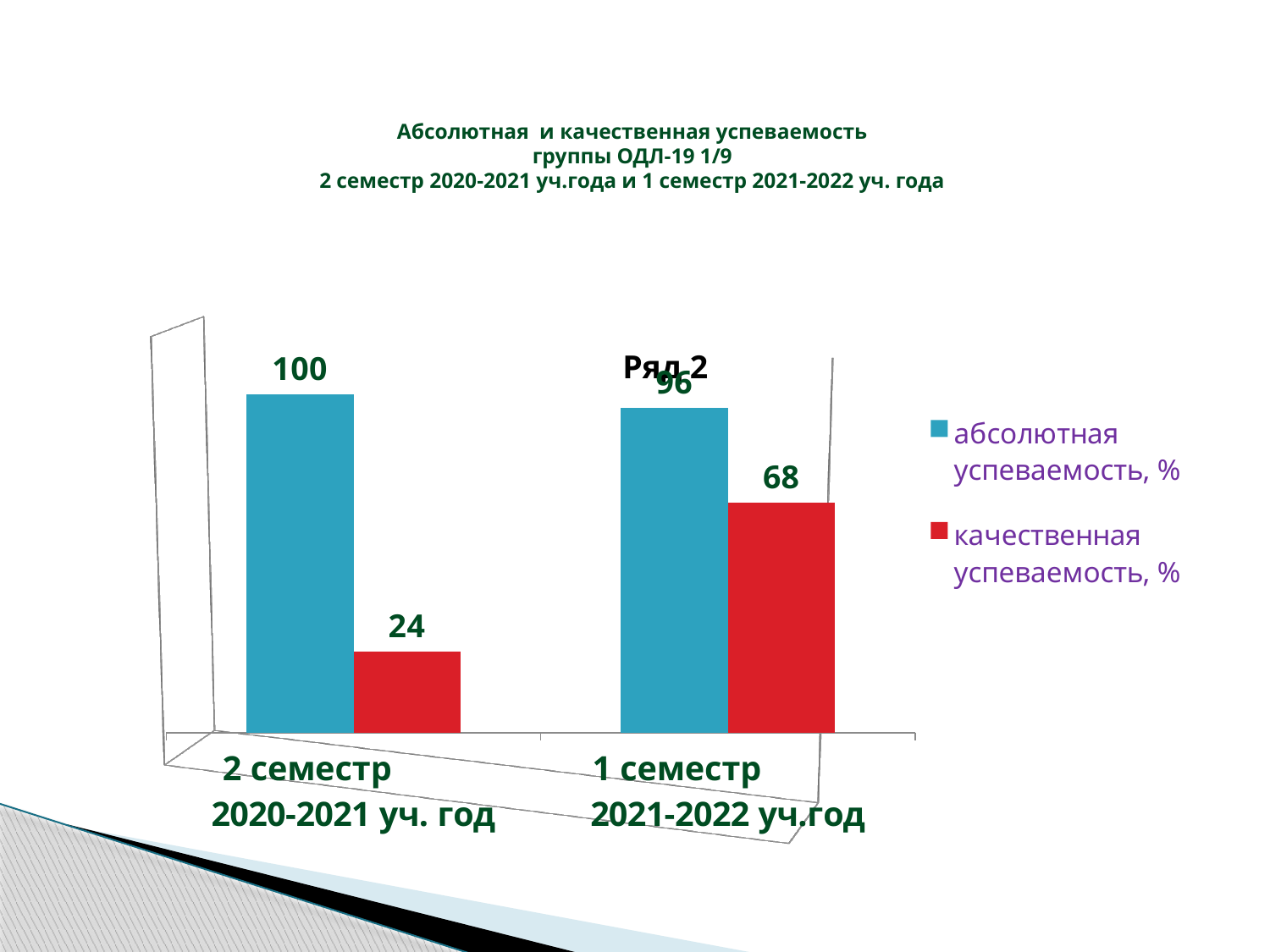
In which semester is качественная успеваемость, % highest? 1 семестр 2021-2022 уч.год What is the difference between качественная успеваемость, % in 1 семестр 2021-2022 уч.год and in 2 семестр 2020-2021 уч. год? 44 What is the value of абсолютная успеваемость, % for 2 семестр 2020-2021 уч. год? 100 What is the value of качественная успеваемость, % for 2 семестр 2020-2021 уч. год? 24 What kind of chart is shown on the slide? bar chart How many series does the legend list? 2 What is the value of качественная успеваемость, % for 1 семестр 2021-2022 уч.год? 68 What is the value of абсолютная успеваемость, % for 1 семестр 2021-2022 уч.год? 96 What is the difference between абсолютная успеваемость, % in 2 семестр 2020-2021 уч. год and in 1 семестр 2021-2022 уч.год? 4 How many semesters (categories) are shown on the x axis? 2 In which semester is абсолютная успеваемость, % lowest? 1 семестр 2021-2022 уч.год Which is larger: абсолютная успеваемость, % or качественная успеваемость, % in 1 семестр 2021-2022 уч.год? абсолютная успеваемость, %